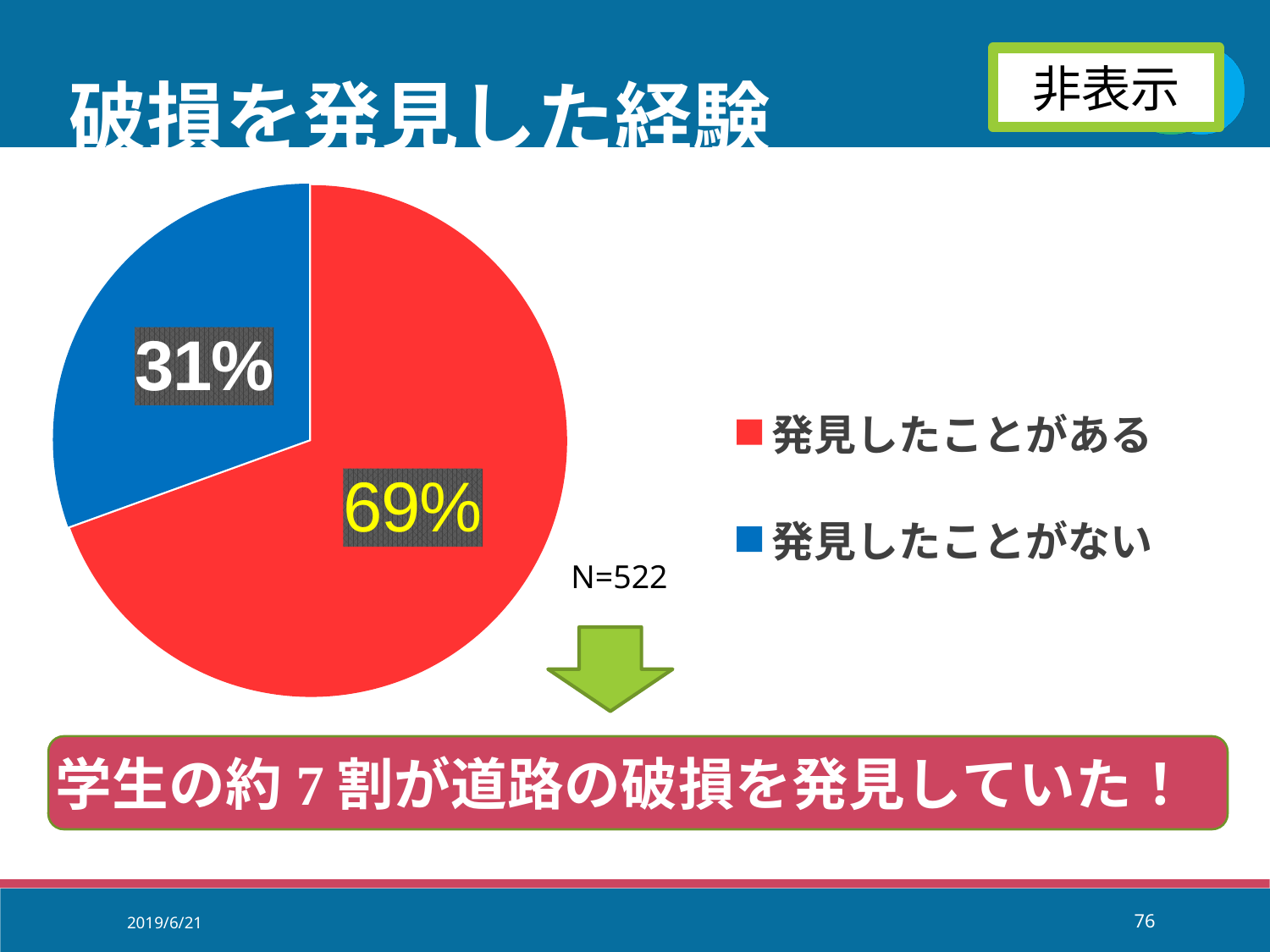
Which category has the smallest slice of the pie? 発見したことがない Which is larger, the slice for 発見したことがある or the slice for 発見したことがない? 発見したことがある What share of the pie does 発見したことがない take? 31% How many entries does the legend list? 2 What kind of chart is shown on the slide? pie chart What sample size (N) is shown next to the pie chart? N=522 What colour is the slice for 発見したことがない? blue What is the difference in percentage points between 発見したことがある and 発見したことがない? 38 What share of the pie does 発見したことがある take? 69% How many slices does the pie chart have? 2 Which category has the largest slice of the pie? 発見したことがある